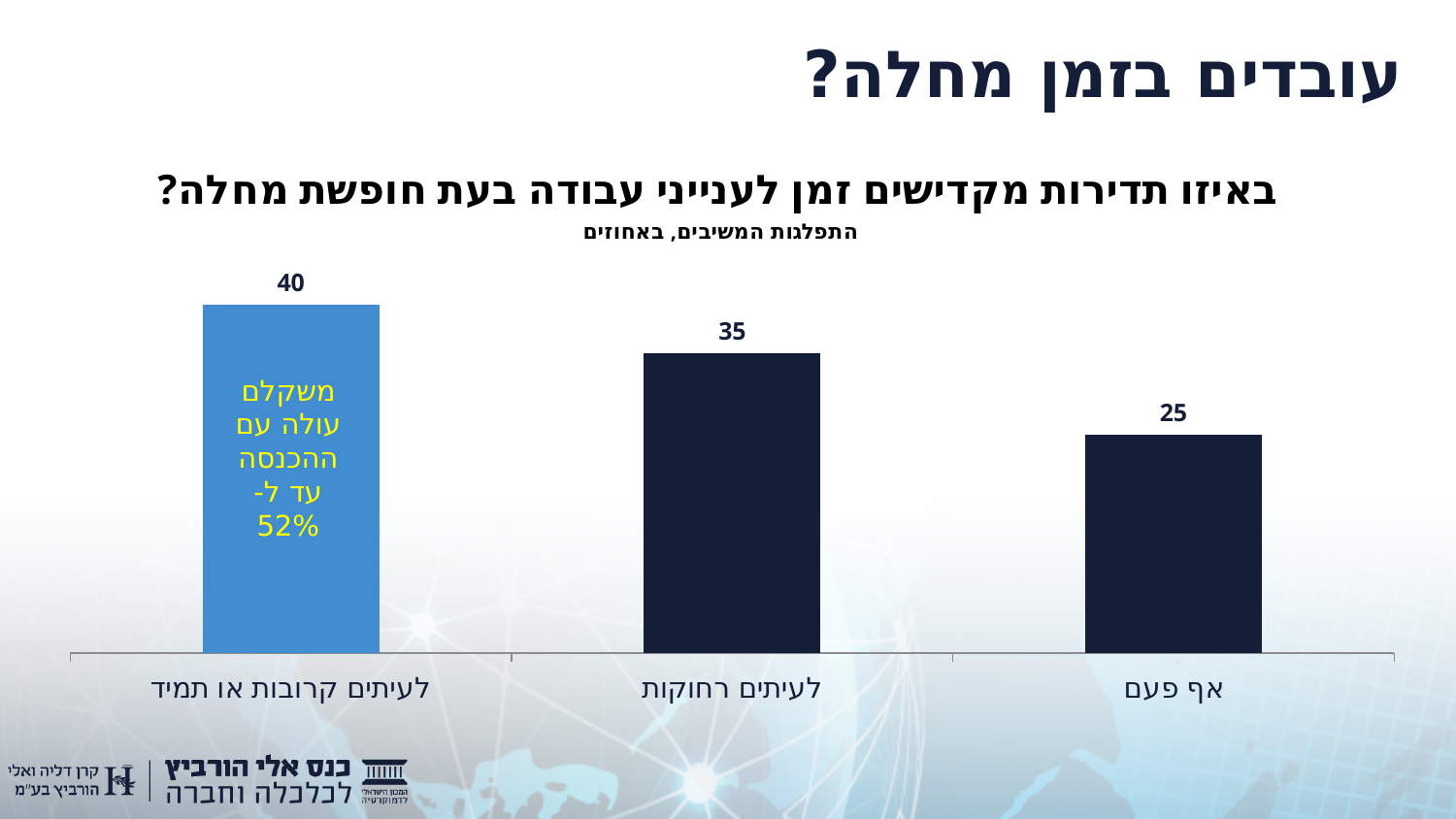
Which is larger, the value for "לעיתים רחוקות" or the value for "אף פעם"? לעיתים רחוקות What kind of chart is shown on the slide? Bar chart Which category has the highest value? לעיתים קרובות או תמיד How many categories are shown in the chart? 3 What is the value for "אף פעם"? 25 What is the difference between the values for "לעיתים קרובות או תמיד" and "לעיתים רחוקות"? 5 Which category has the lowest value? אף פעם Do the values rise or fall moving from the rightmost bar to the leftmost bar? Rise What is the difference between the values for "לעיתים קרובות או תמיד" and "אף פעם"? 15 What is the value for "לעיתים קרובות או תמיד"? 40 What percentage is mentioned in the yellow annotation inside the blue bar? 52% What is the value for "לעיתים רחוקות"? 35